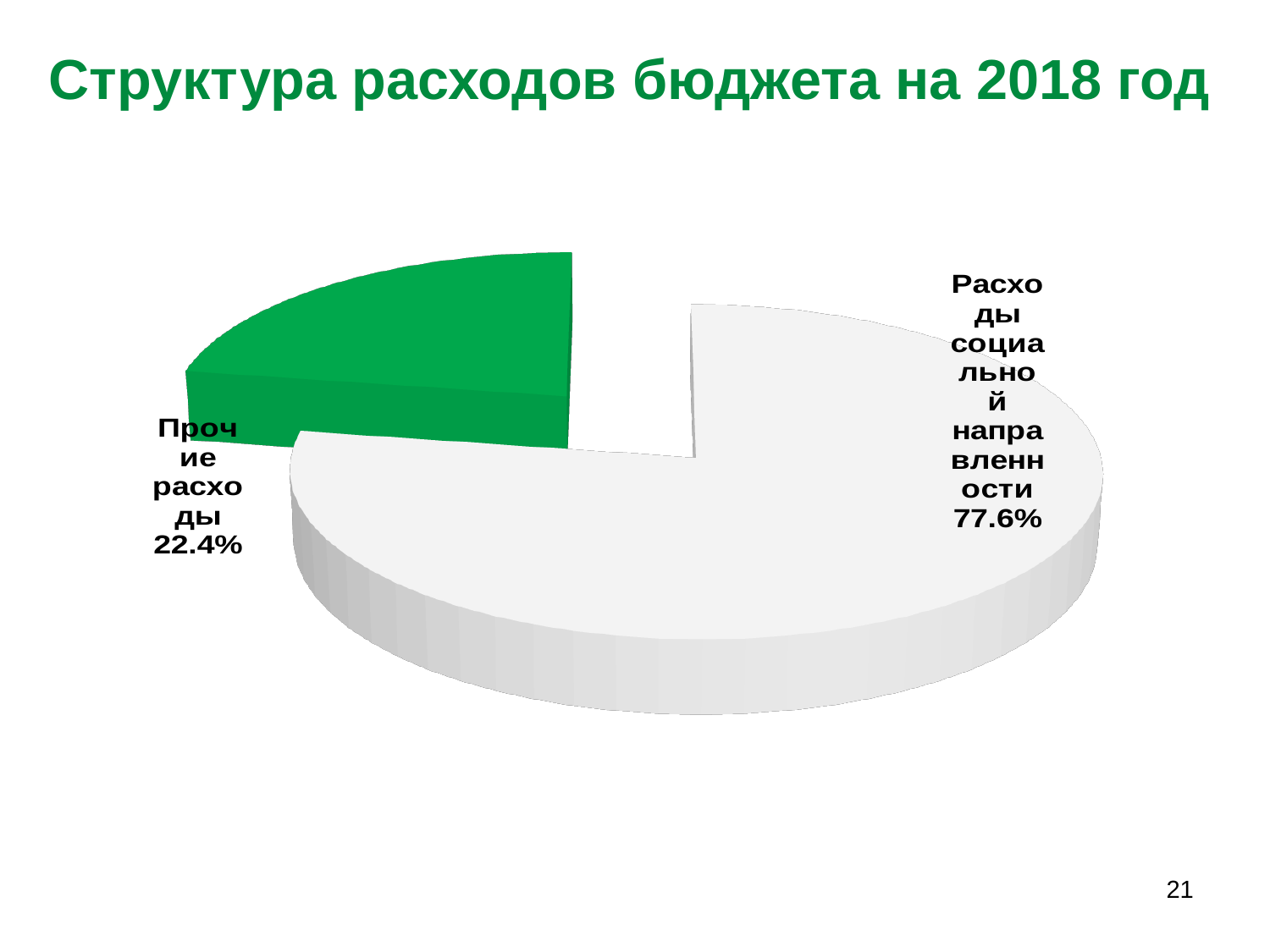
Which slice of the pie is the largest? Расходы социальной направленности What kind of chart is shown on the slide? Pie chart How many slices does the pie chart have? 2 Which slice of the pie is the smallest? Прочие расходы What share of the pie is labelled "Расходы социальной направленности"? 77.6% What is the total of the two slice percentages shown? 100% What colour is the "Прочие расходы" slice? Green What is the difference in percentage points between "Расходы социальной направленности" and "Прочие расходы"? 55.2 What is the title of the slide? Структура расходов бюджета на 2018 год Which is larger: "Прочие расходы" or "Расходы социальной направленности"? Расходы социальной направленности What share of the pie is labelled "Прочие расходы"? 22.4%